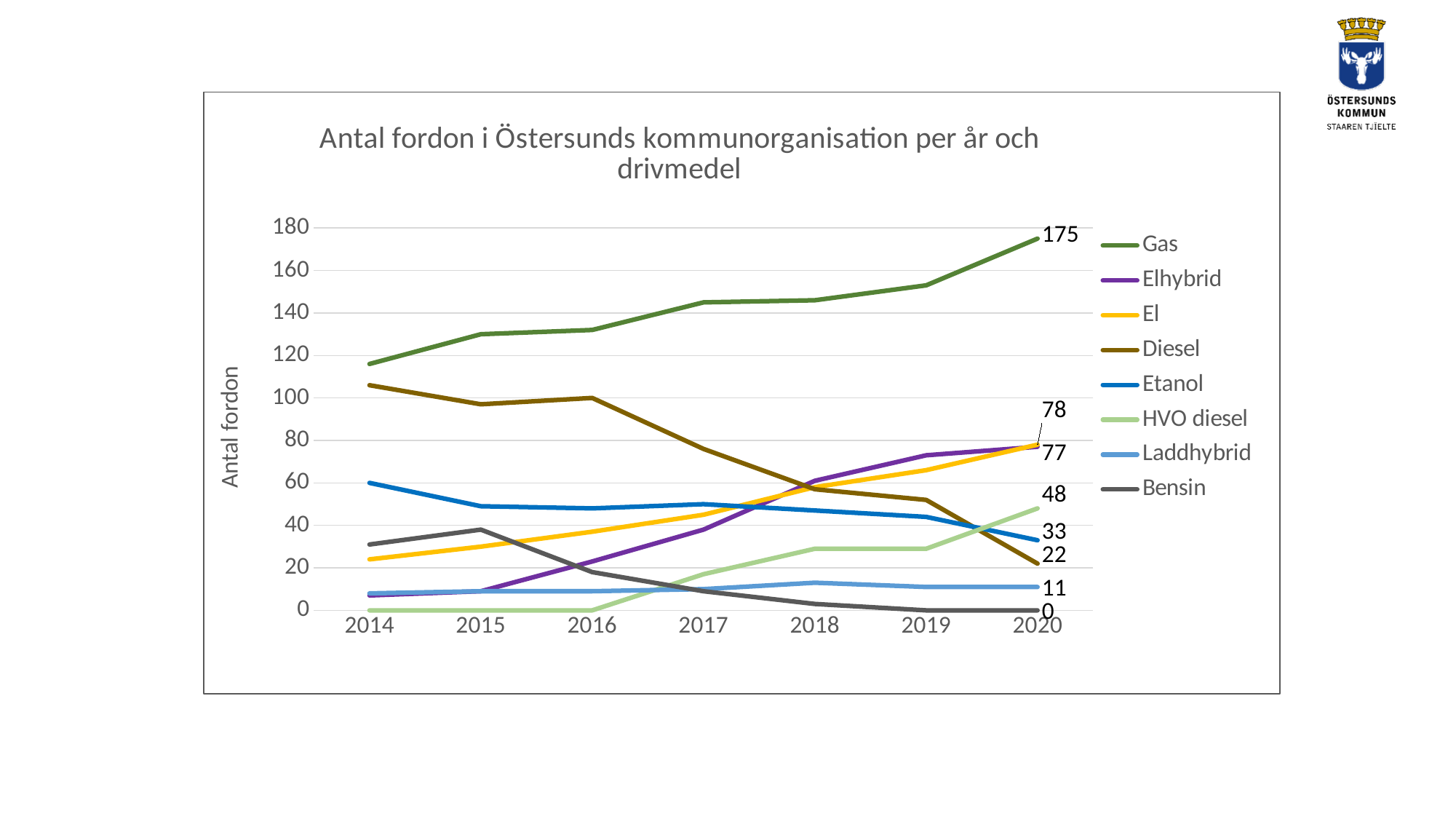
In 2020, which is larger, Etanol or Diesel? Etanol What is the value for Gas in 2020? 175 Is the value for Gas in 2014 greater or less than 100? greater How many years are shown on the x axis? 7 Which series has the lowest value in 2020? Bensin What is the difference between Gas and HVO diesel in 2020? 127 Which series has the highest value in 2020? Gas What is the value for HVO diesel in 2020? 48 What is the value for Bensin in 2020? 0 What kind of chart is shown on the slide? line chart What is the value for Diesel in 2020? 22 How many series does the legend list? 8